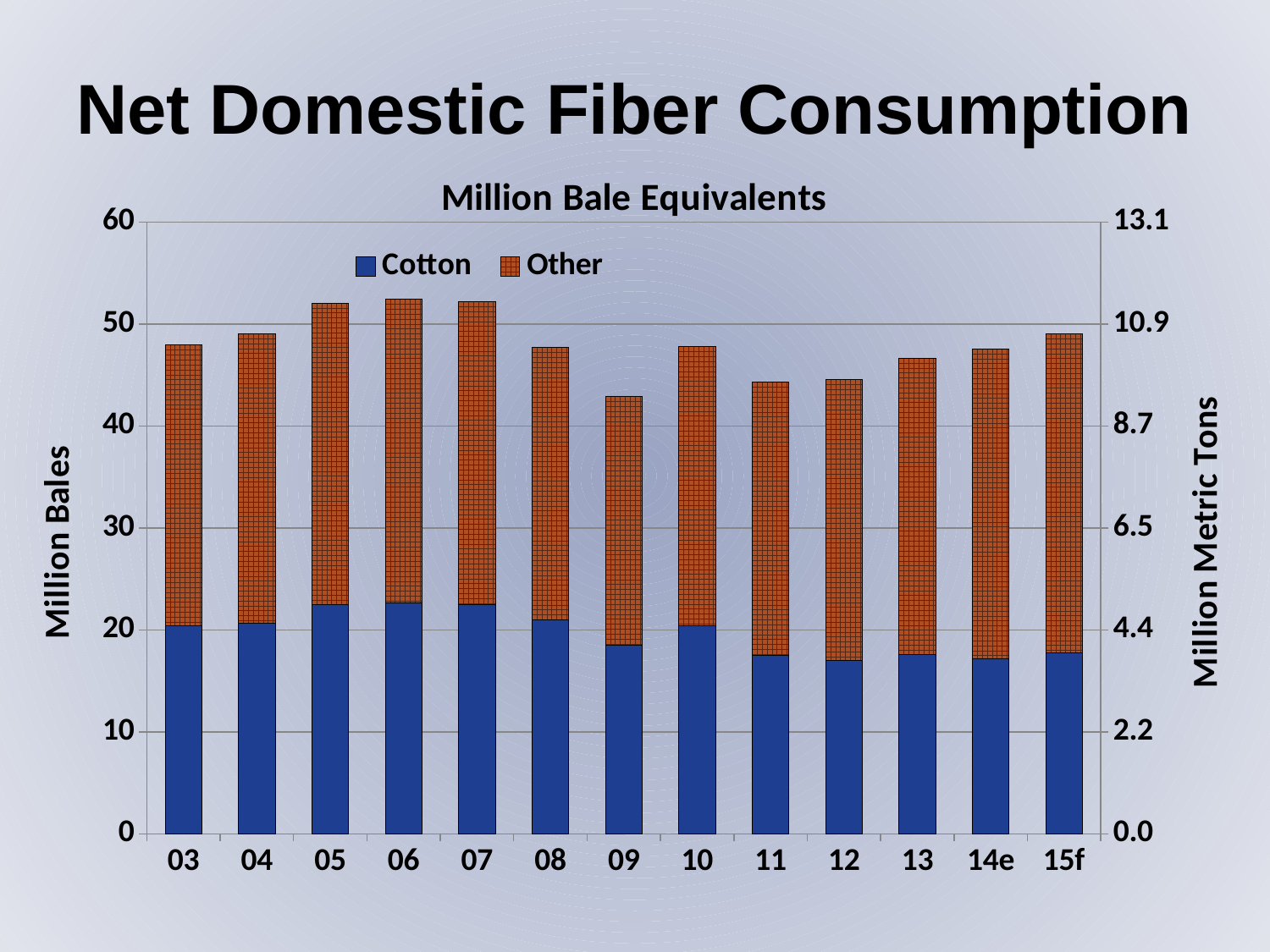
Which year has the larger total bar, 06 or 09? 06 Is the Cotton value for 09 greater or less than 20 million bales? less What is the label on the right-hand vertical axis? Million Metric Tons Is the total bar for 06 greater or less than 50 million bales? greater How many series does the legend list? 2 Which year has the larger Cotton value, 05 or 12? 05 What kind of chart is shown on the slide? Stacked bar chart Which year has the lowest total fiber consumption? 09 Is the Cotton value for 05 greater or less than 20 million bales? greater Do the total bars rise or fall from 06 to 09? fall How many years (categories) are shown along the x axis? 13